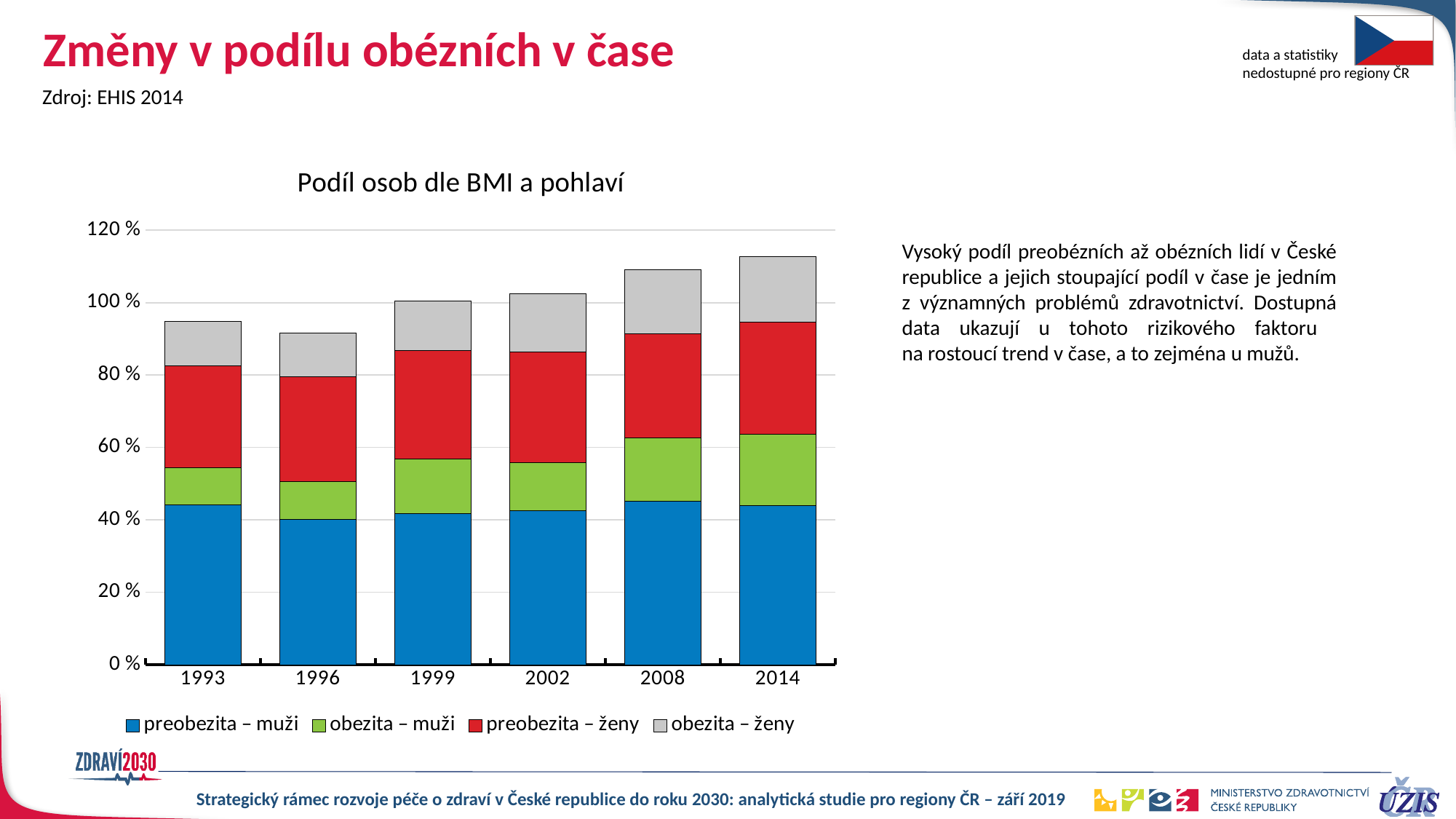
How many series does the chart legend list? 4 What kind of chart is shown on the slide? stacked bar chart What is the title of the chart? Podíl osob dle BMI a pohlaví Is the total height of the stacked bar for 1993 greater or less than 100 %? less Is the total height of the stacked bar for 2014 greater or less than 100 %? greater How many years are shown on the x axis of the chart? 6 Which series is shown in blue in the chart? preobezita – muži Is the value for preobezita – muži in 2008 greater or less than 40 %? greater Which year has the shortest stacked bar in the chart? 1996 Which year has the tallest stacked bar in the chart? 2014 Which stacked bar is taller, 2014 or 1993? 2014 Do the total stacked bar heights rise or fall from 1996 to 2014? rise